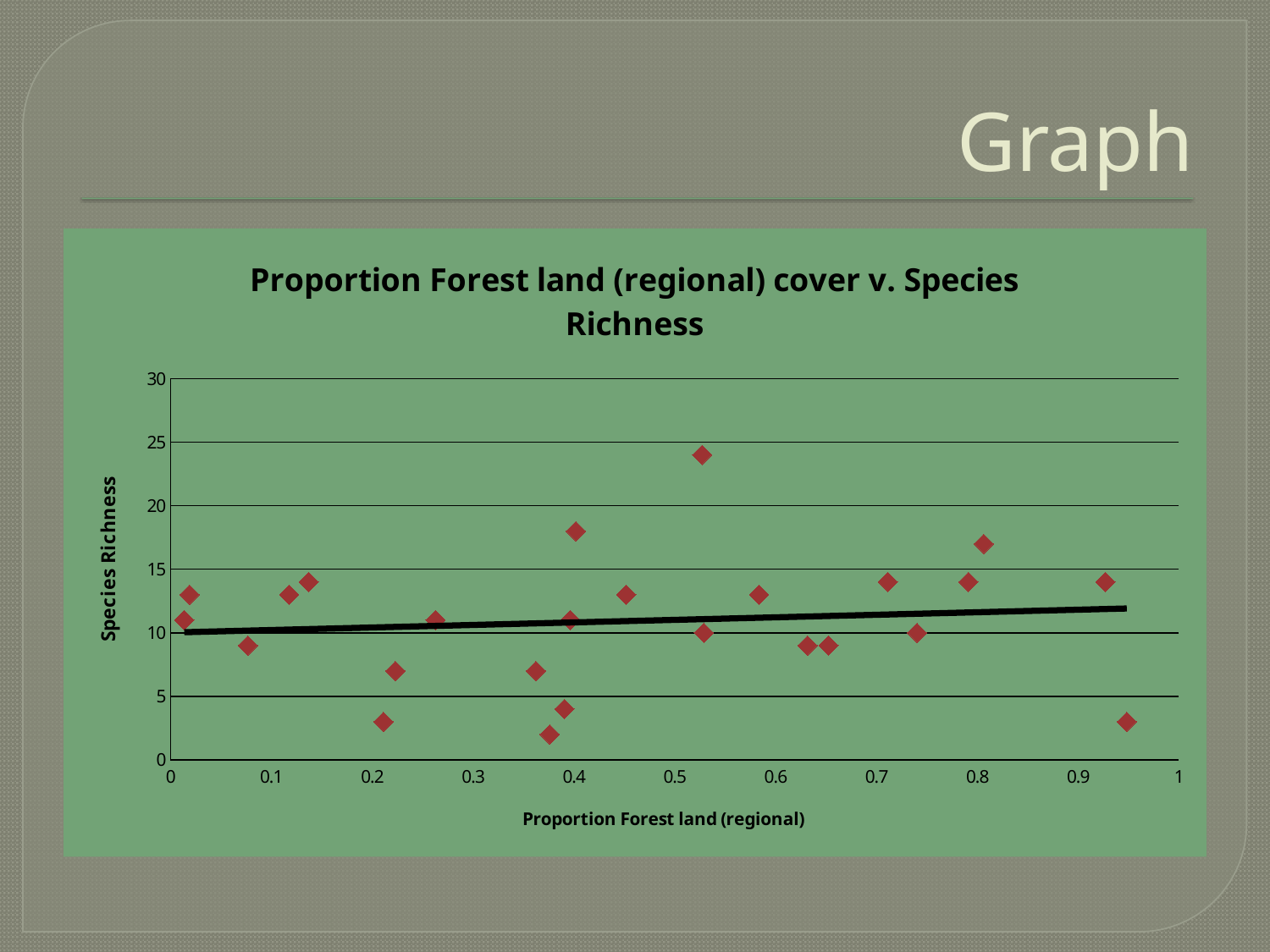
What is the label of the y axis? Species Richness What is the maximum value shown on the y axis? 30 What kind of chart is shown on the slide? scatter plot Does the fitted trend line rise or fall as Proportion Forest land increases? rise Is the highest Species Richness value plotted greater or less than 20? greater Is the Species Richness of the highest point near 0.8 on the x axis greater or less than 15? greater Is the Species Richness of the point plotted at about 0.95 on the x axis greater or less than 5? less Which has the higher Species Richness: the highest point near 0.5 on the x axis or the highest point near 0.4 on the x axis? the highest point near 0.5 What is the title of the chart? Proportion Forest land (regional) cover v. Species Richness How many tick labels are shown on the x axis? 11